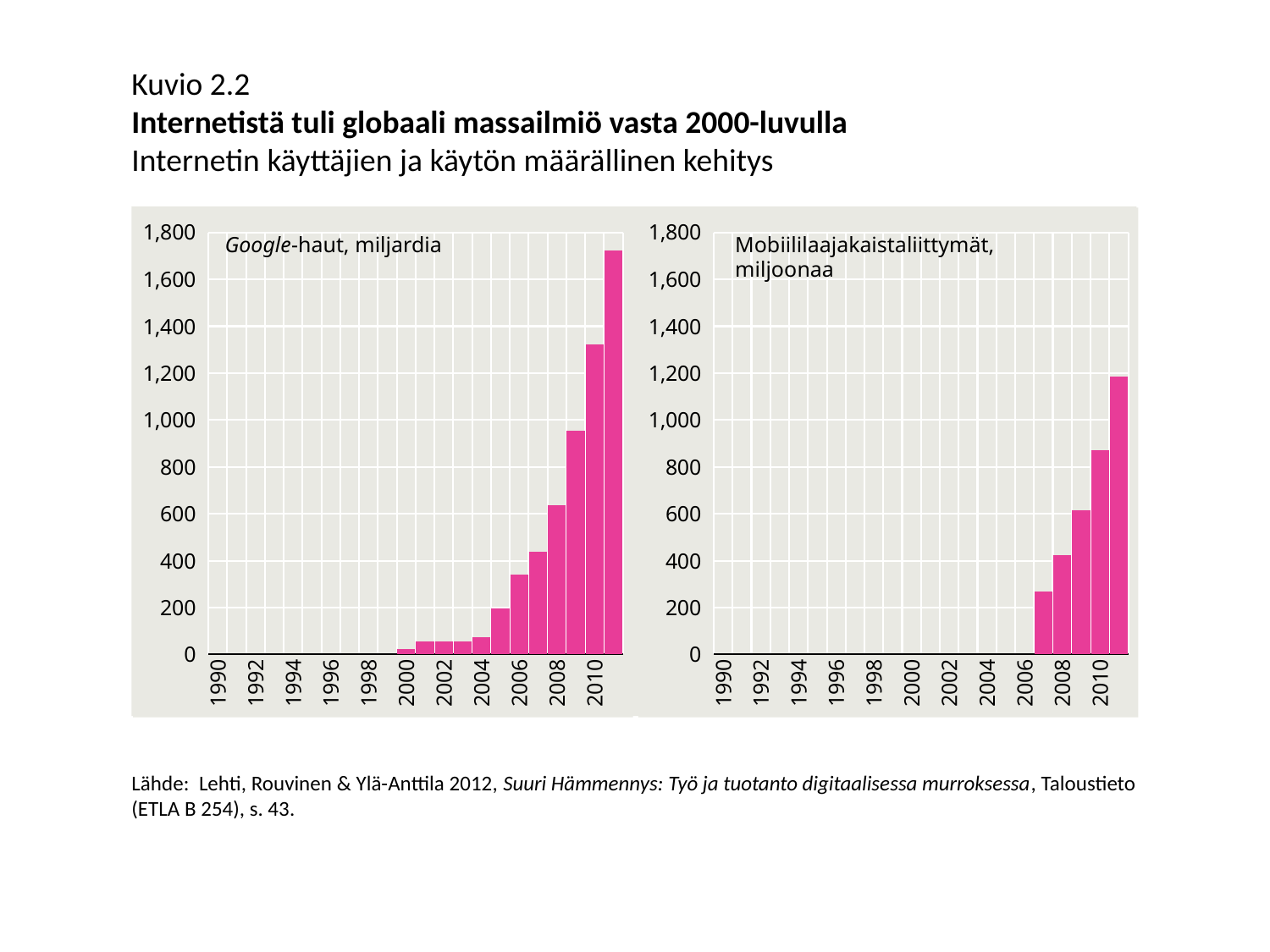
In the left chart (Google-haut, miljardia), is the value for 2010 greater or less than 1,400? less In the left chart (Google-haut, miljardia), which year has the highest value? 2011 What is the title of the right chart? Mobiililaajakaistaliittymät, miljoonaa What kind of chart is the left chart titled 'Google-haut, miljardia'? bar chart In the right chart (Mobiililaajakaistaliittymät, miljoonaa), is the value for 2007 greater or less than 400? less In the right chart (Mobiililaajakaistaliittymät, miljoonaa), is the value for 2010 greater or less than 800? greater In the left chart (Google-haut, miljardia), do the values rise or fall from 2005 to 2011? rise In the right chart (Mobiililaajakaistaliittymät, miljoonaa), which year has the highest value? 2011 In the right chart (Mobiililaajakaistaliittymät, miljoonaa), do the values rise or fall from 2007 to 2011? rise Which is larger for 2011: the value in the left chart (Google-haut) or the value in the right chart (Mobiililaajakaistaliittymät)? Google-haut (left chart)